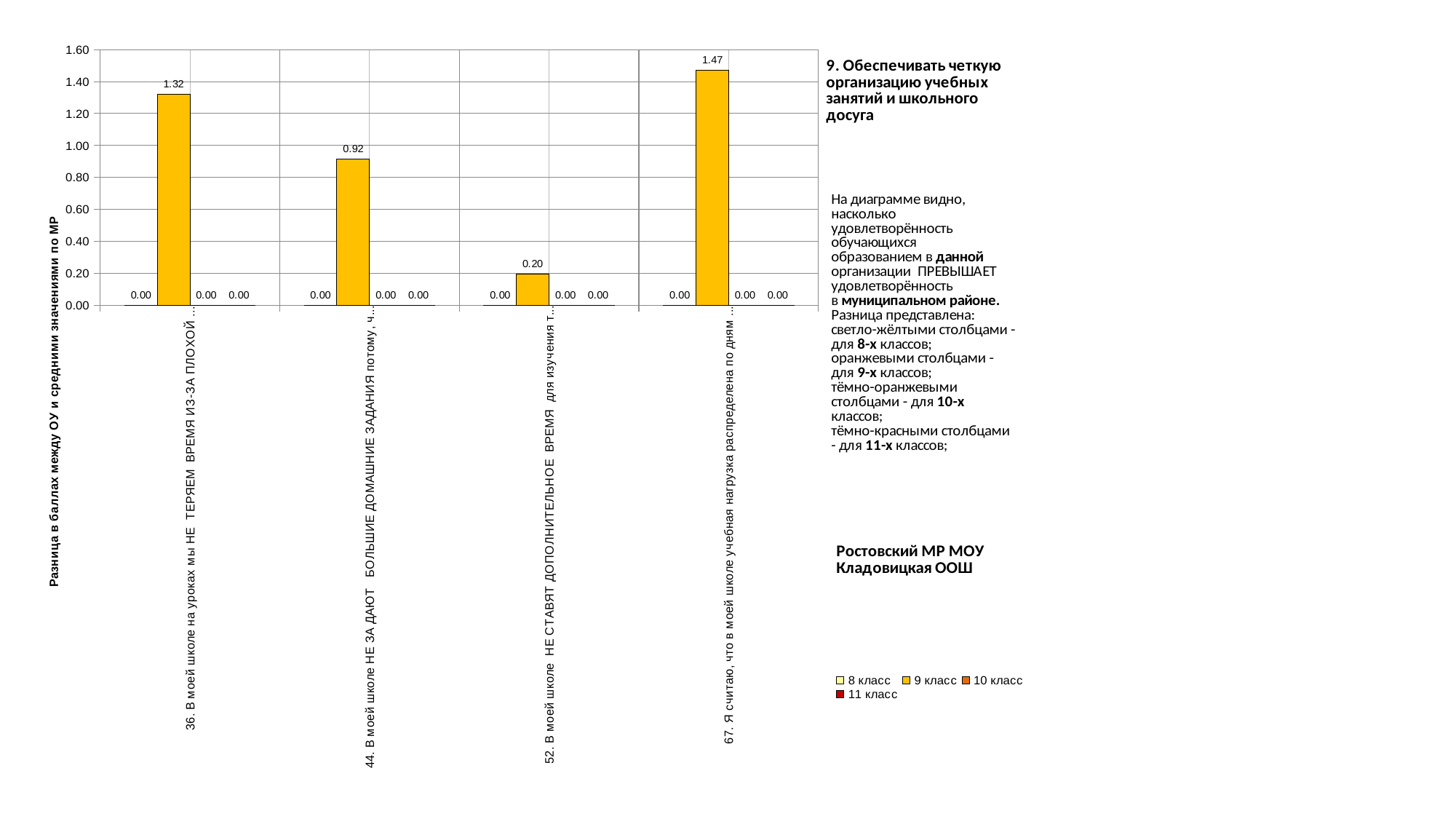
What is the value for 8 класс for statement 36? 0.00 What is the value for 9 класс for statement 44? 0.92 What is the difference between the 9 класс values for statements 67 and 36? 0.15 How many categories (statements) are shown on the x axis? 4 Which is larger: the 9 класс value for statement 44 or for statement 52? statement 44 What is the value for 9 класс for statement 67? 1.47 For which statement is the 9 класс value highest? 67 How many series does the legend list? 4 What is the value for 9 класс for statement 36? 1.32 What is the value for 9 класс for statement 52? 0.20 What type of chart is shown on the slide? bar chart For which statement is the 9 класс value lowest? 52